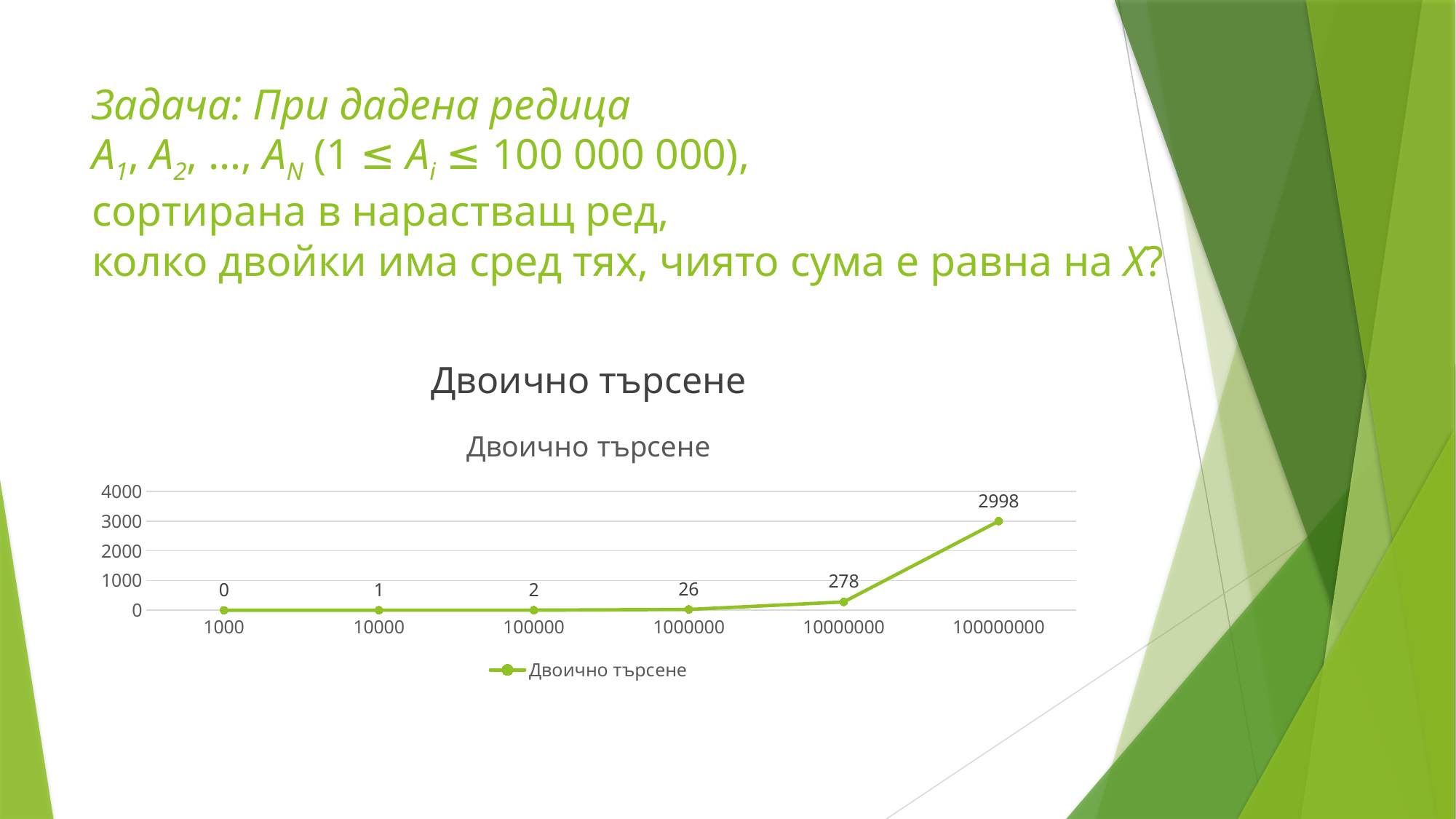
What is the difference between the values for 100000000 and 10000000? 2720 Which is larger, the value for 1000000 or the value for 100000? 1000000 What is the value for 100000000 in the chart? 2998 What is the value for 1000000 in the chart? 26 Do the values rise or fall along the x axis? rise What is the value for 10000000 in the chart? 278 How many data points are plotted in the chart? 6 Which category has the highest value? 100000000 What kind of chart is shown on the slide? line chart What is the value for 1000 in the chart? 0 Which category has the lowest value? 1000 Is the value for 100000000 greater or less than 2000? greater